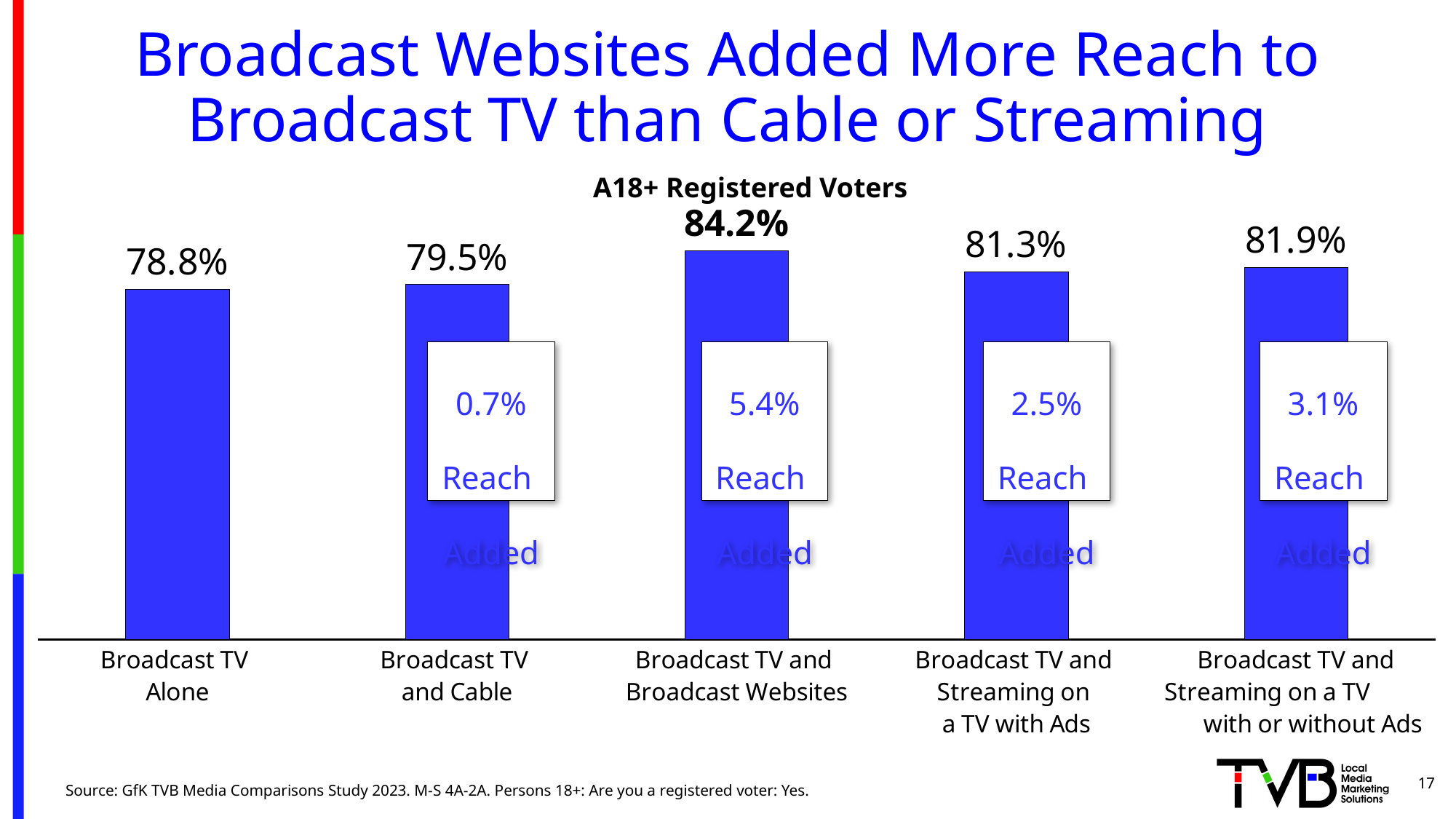
What is the difference between Broadcast TV and Broadcast Websites and Broadcast TV Alone? 5.4% What is the value for Broadcast TV and Streaming on a TV with or without Ads? 81.9% What is the subtitle shown above the chart? A18+ Registered Voters Which category has the highest value? Broadcast TV and Broadcast Websites What kind of chart is shown on the slide? Bar chart What is the difference between Broadcast TV and Cable and Broadcast TV Alone? 0.7% Which is larger: Broadcast TV and Cable or Broadcast TV and Streaming on a TV with Ads? Broadcast TV and Streaming on a TV with Ads What is the value for Broadcast TV Alone? 78.8% What is the value for Broadcast TV and Broadcast Websites? 84.2% Which category has the lowest value? Broadcast TV Alone What is the value for Broadcast TV and Streaming on a TV with Ads? 81.3% How many categories are shown in the chart? 5